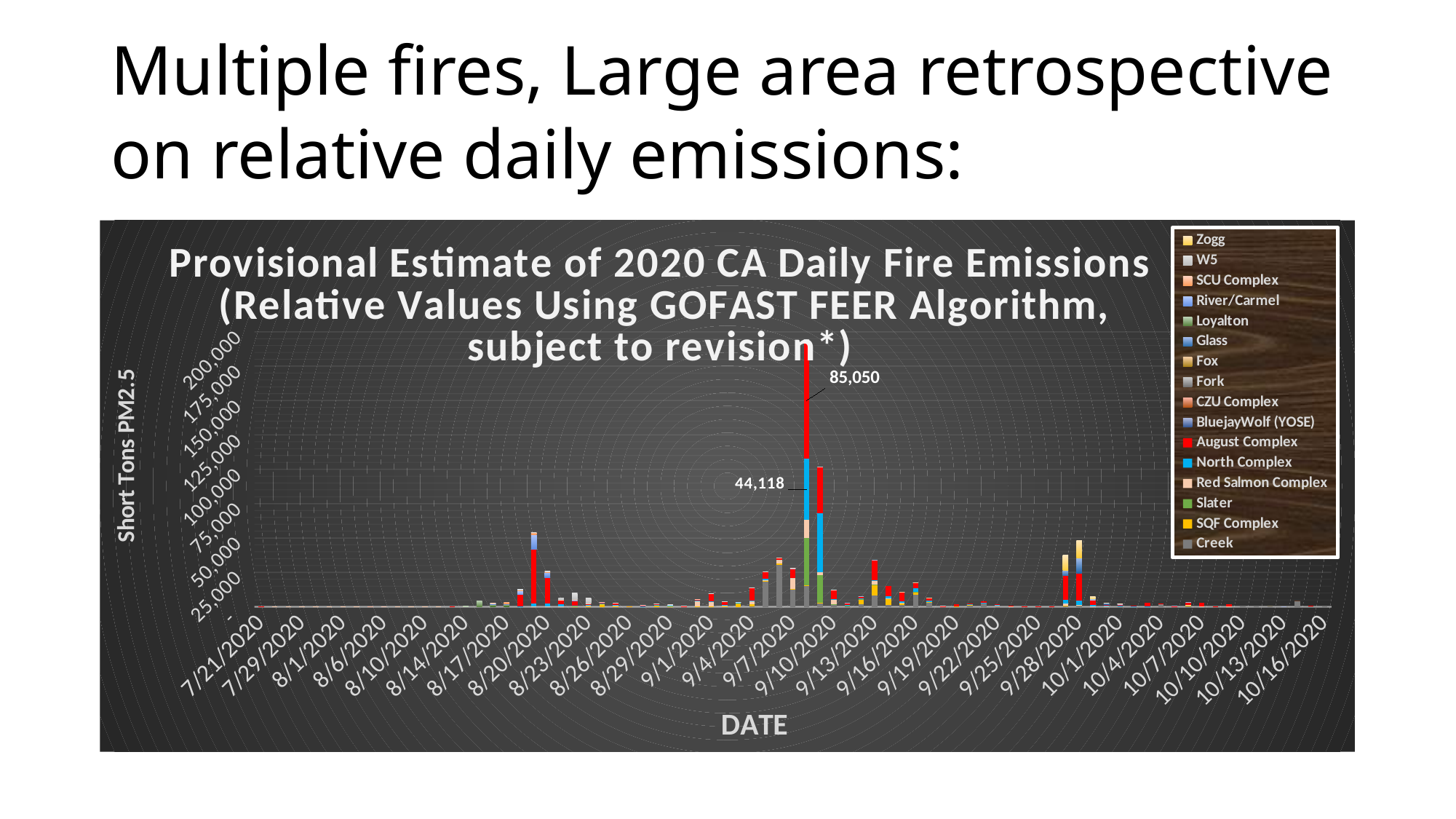
What is the first date label on the horizontal axis? 7/21/2020 Which of the two labeled values, 85,050 or 44,118, is larger? 85,050 What is the difference between the two labeled values 85,050 and 44,118? 40,932 What value is printed on the data label pointing to the blue North Complex segment of the tallest bar? 44,118 Is the total height of the tallest bar greater or less than 150,000? greater How many data labels are printed on the chart? 2 What is the title of the horizontal axis? DATE How many series does the chart's legend list? 16 What is the title of the vertical axis? Short Tons PM2.5 What value is printed on the data label pointing to the red August Complex segment of the tallest bar? 85,050 What kind of chart is shown on the slide? Stacked bar chart What is the highest tick value shown on the vertical axis? 200,000